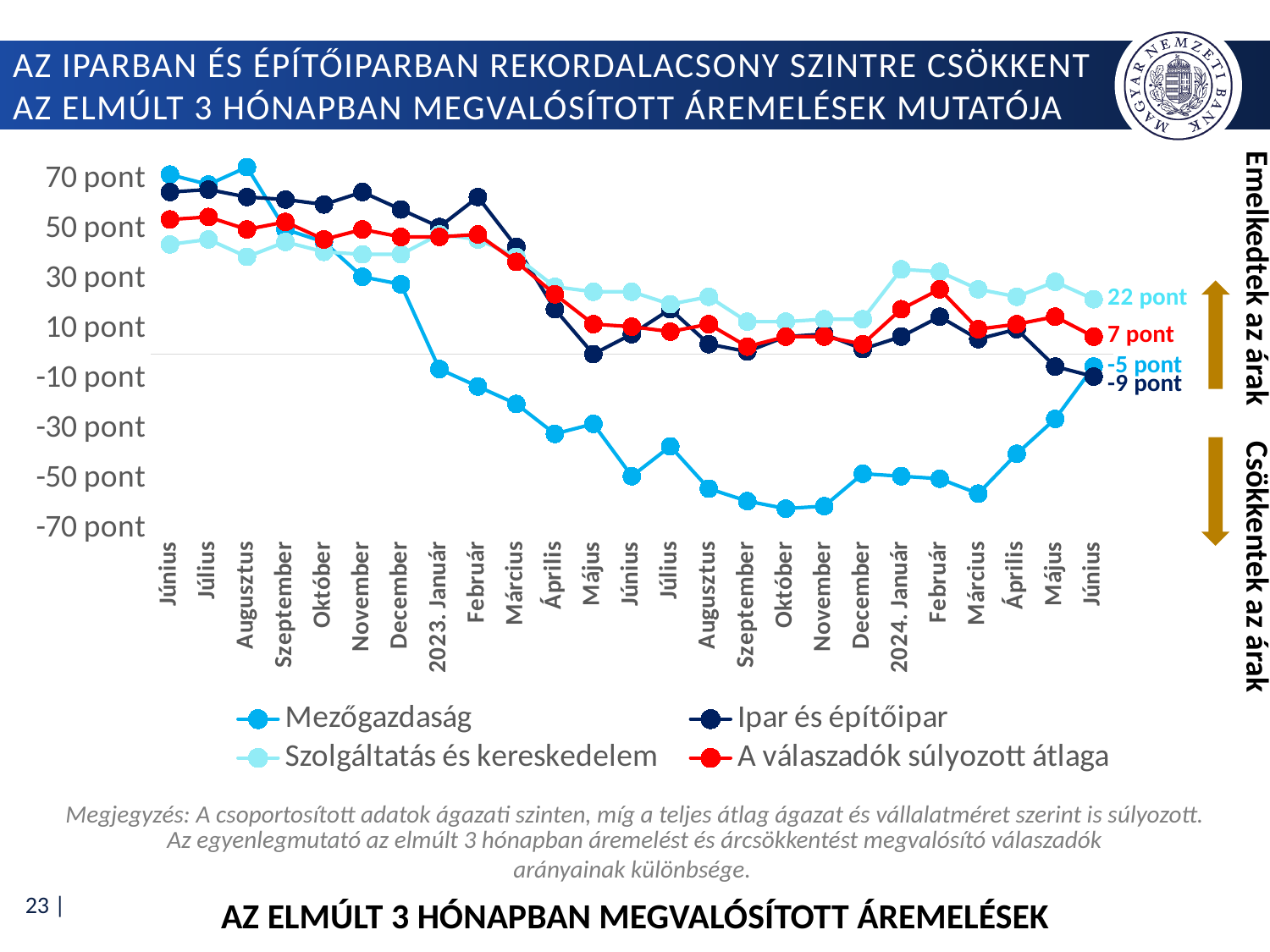
What is the value for A válaszadók súlyozott átlaga in Június 2024? 7 pont Is the value for Mezőgazdaság in Október 2023 greater or less than -50 pont? less What is the value for Szolgáltatás és kereskedelem in Június 2024? 22 pont What kind of chart is shown on the slide? line chart What is the value for Mezőgazdaság in Június 2024? -5 pont How many series does the legend list? 4 In Június 2024, which is larger: the value for Mezőgazdaság or the value for Ipar és építőipar? Mezőgazdaság Which series has the highest value in Június 2024? Szolgáltatás és kereskedelem What is the value for Ipar és építőipar in Június 2024? -9 pont Which series has the lowest value in Június 2024? Ipar és építőipar What is the difference between the Június 2024 values of Szolgáltatás és kereskedelem and A válaszadók súlyozott átlaga? 15 pont Does the Mezőgazdaság series rise or fall from Június 2022 to Október 2023? fall